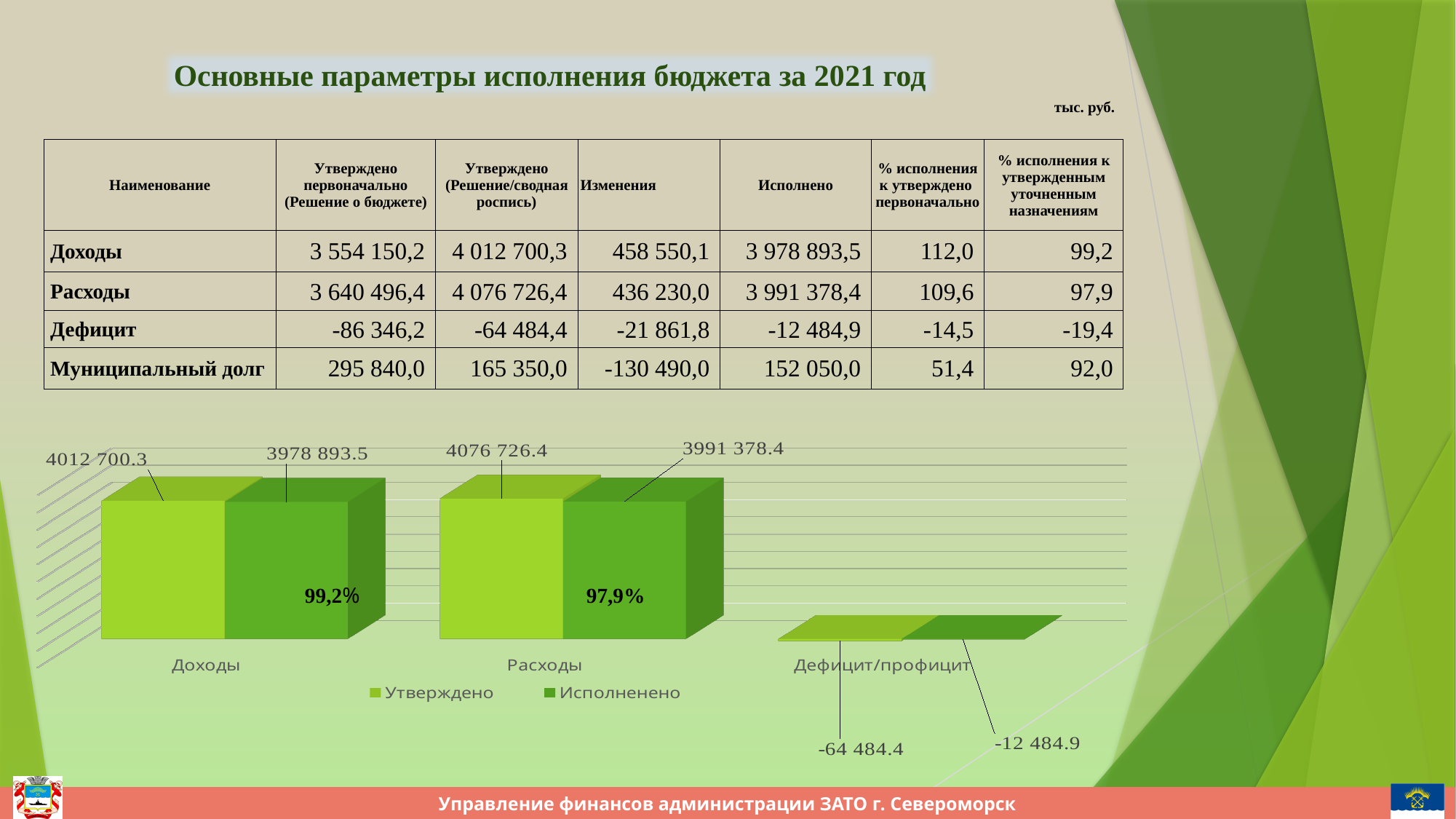
How many categories are shown on the chart's x axis? 3 What is the Исполненено value for Расходы on the chart? 3991 378.4 What is the Утверждено value for Расходы on the chart? 4076 726.4 What kind of chart is shown at the bottom of the slide? bar chart What percentage label is printed on the Исполненено bar for Доходы? 99,2% What is the Исполненено value for Доходы on the chart? 3978 893.5 What is the Утверждено value for Дефицит/профицит on the chart? -64 484.4 What is the Утверждено value for Доходы on the chart? 4012 700.3 How many series does the chart legend list? 2 Which is larger on the chart: the Утверждено value for Доходы or the Утверждено value for Расходы? Расходы Which category has the lowest Исполненено value on the chart? Дефицит/профицит What is the Исполненено value for Дефицит/профицит on the chart? -12 484.9